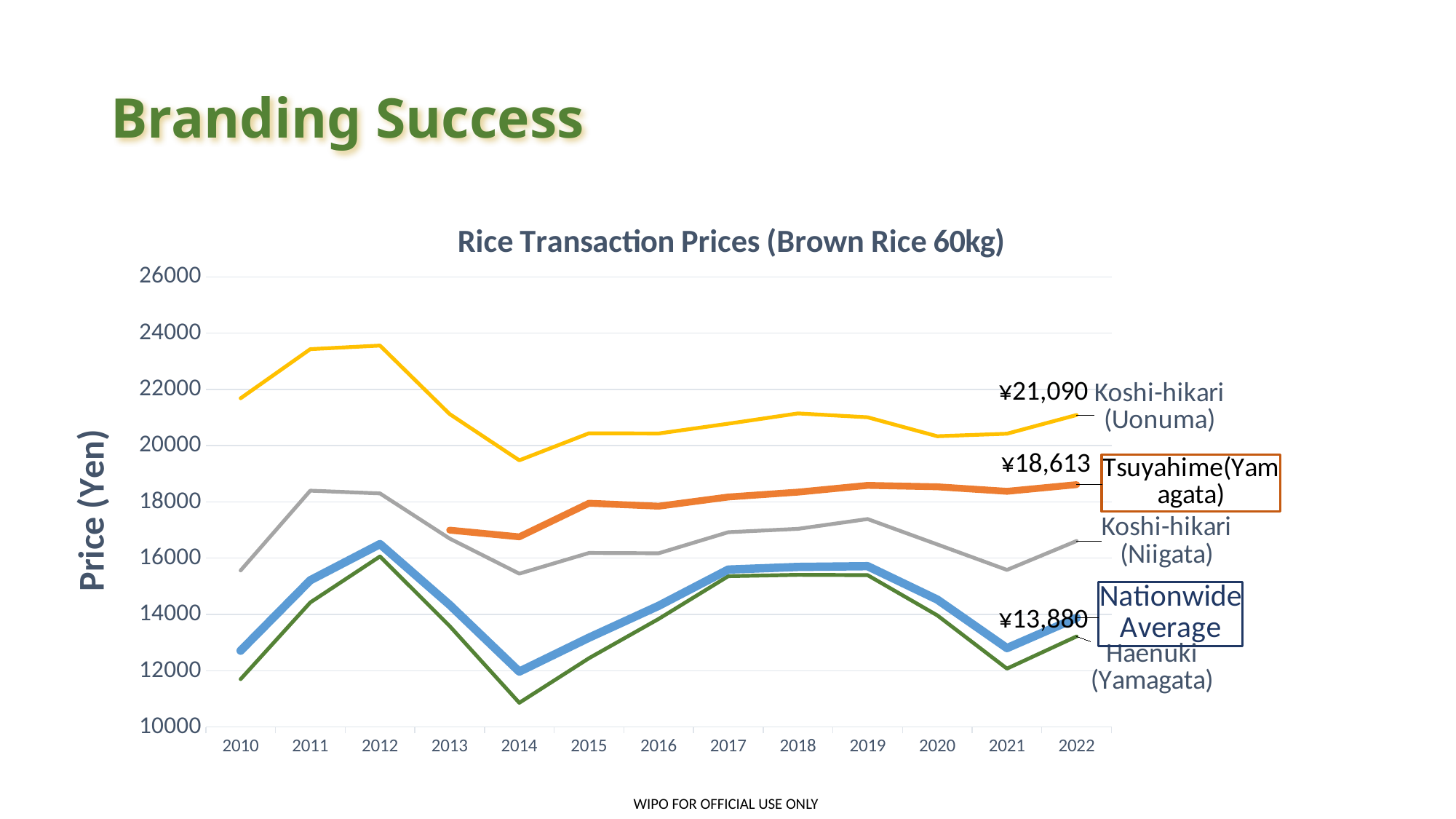
Does the price for Tsuyahime (Yamagata) rise or fall from 2014 to 2019? rise What is the difference between the 2022 prices of Koshi-hikari (Uonuma) and Tsuyahime (Yamagata)? ¥2,477 What is the title of the chart? Rice Transaction Prices (Brown Rice 60kg) Is the price for Koshi-hikari (Uonuma) in 2012 greater or less than 22000? greater What kind of chart is shown on the slide? line chart Which series has the lowest price in 2014? Haenuki (Yamagata) What is the difference between the 2022 prices of Tsuyahime (Yamagata) and the Nationwide Average? ¥4,733 What is the 2022 price for Tsuyahime (Yamagata)? ¥18,613 Which series has the highest price in 2022? Koshi-hikari (Uonuma) What is the 2022 price for the Nationwide Average? ¥13,880 What is the 2022 price for Koshi-hikari (Uonuma)? ¥21,090 How many years are shown on the x axis? 13